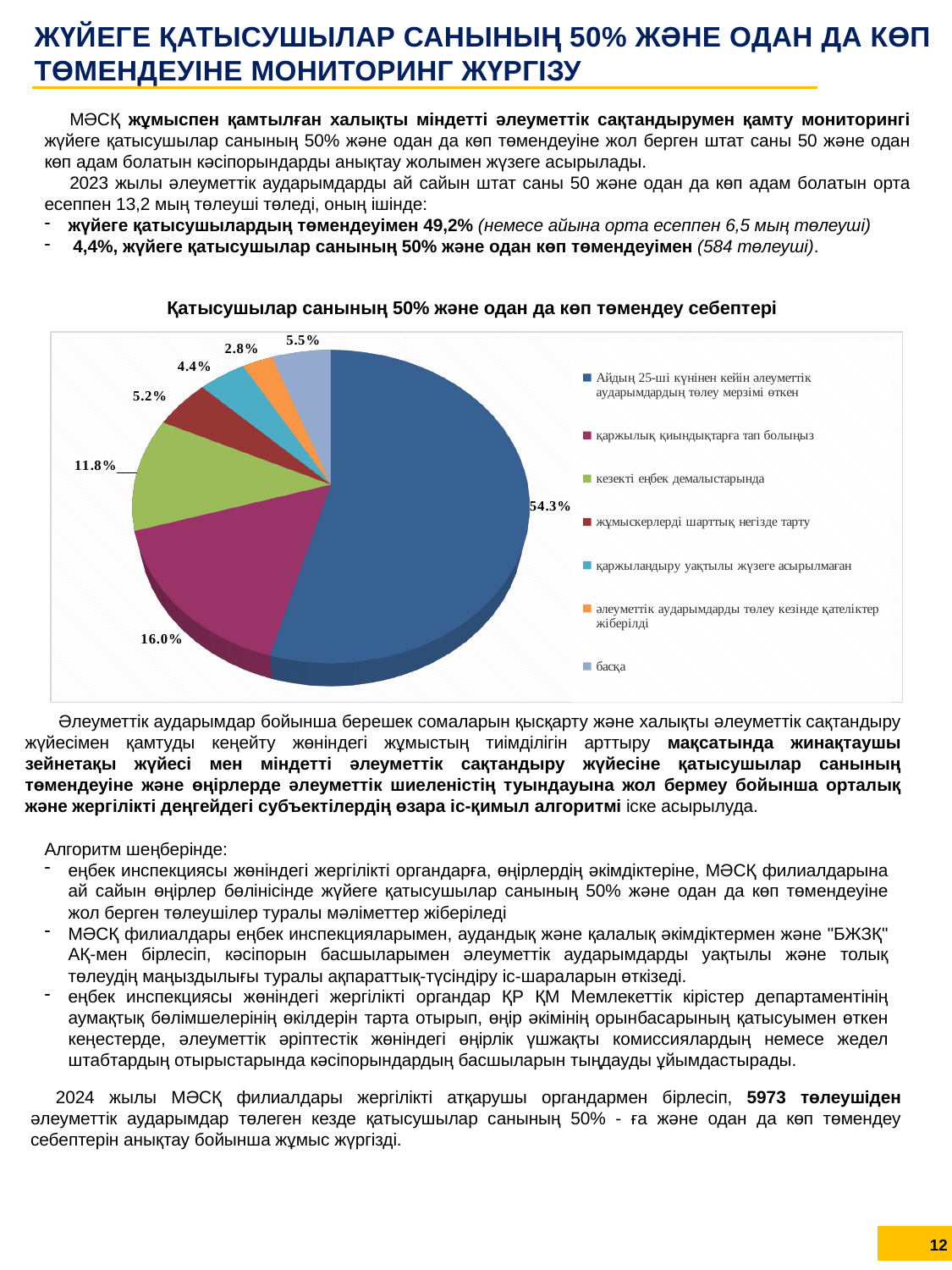
What is the value shown for 'басқа'? 5.5% Which category has the smallest slice of the pie? әлеуметтік аударымдарды төлеу кезінде қателіктер жіберілді What share of the pie is labelled for 'Айдың 25-ші күнінен кейін әлеуметтік аударымдардың төлеу мерзімі өткен'? 54.3% How many entries does the chart legend list? 7 What is the title of the chart? Қатысушылар санының 50% және одан да көп төмендеу себептері Which is larger: the value for 'жұмыскерлерді шарттық негізде тарту' or the value for 'қаржыландыру уақытылы жүзеге асырылмаған'? жұмыскерлерді шарттық негізде тарту Which category has the largest slice of the pie? Айдың 25-ші күнінен кейін әлеуметтік аударымдардың төлеу мерзімі өткен What kind of chart is shown on the slide? pie chart What is the value shown for 'кезекті еңбек демалыстарында'? 11.8% What is the value shown for 'қаржылық қиындықтарға тап болыңыз'? 16.0% What is the difference between the values for 'қаржылық қиындықтарға тап болыңыз' and 'кезекті еңбек демалыстарында'? 4.2% How many slices does the pie chart have? 7